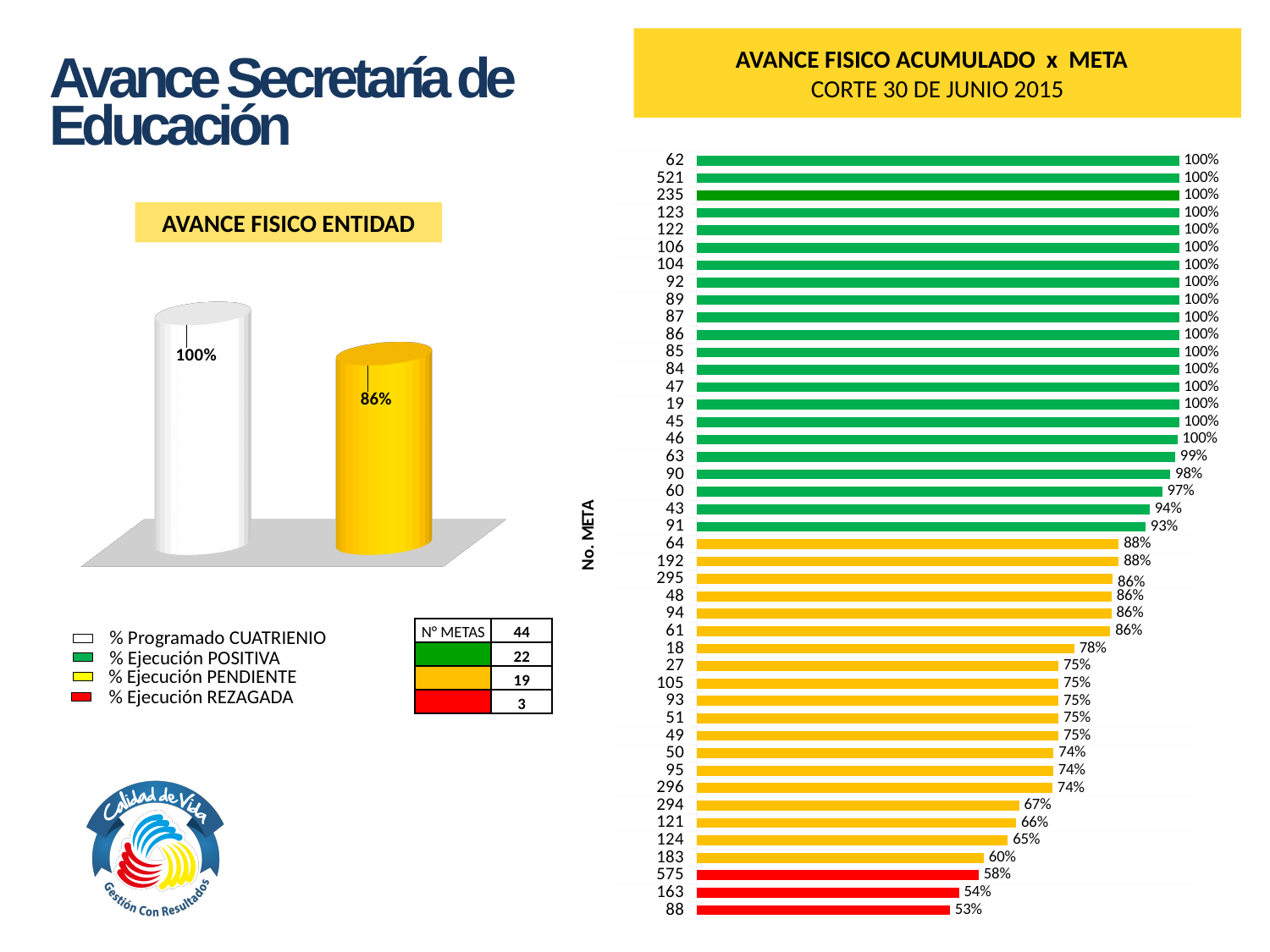
In the chart titled AVANCE FISICO ACUMULADO x META, what is the value for meta 183? 60% In the chart titled AVANCE FISICO ACUMULADO x META, what is the value for meta 575? 58% In the chart titled AVANCE FISICO ACUMULADO x META, how many bars are coloured red? 3 In the chart titled AVANCE FISICO ACUMULADO x META, what is the difference between the values for meta 18 and meta 88? 25 percentage points In the chart titled AVANCE FISICO ENTIDAD, what is the value of the white bar (% Programado CUATRIENIO)? 100% In the chart titled AVANCE FISICO ENTIDAD, what is the value of the yellow bar? 86% What kind of chart is the one titled AVANCE FISICO ACUMULADO x META? Bar chart In the chart titled AVANCE FISICO ENTIDAD, what is the difference between the two bars? 14 percentage points In the chart titled AVANCE FISICO ACUMULADO x META, which has a higher value, meta 294 or meta 124? 294 In the chart titled AVANCE FISICO ACUMULADO x META, which meta has the lowest value? 88 In the chart titled AVANCE FISICO ACUMULADO x META, what is the value for meta 63? 99% How many metas are plotted in the chart titled AVANCE FISICO ACUMULADO x META? 44